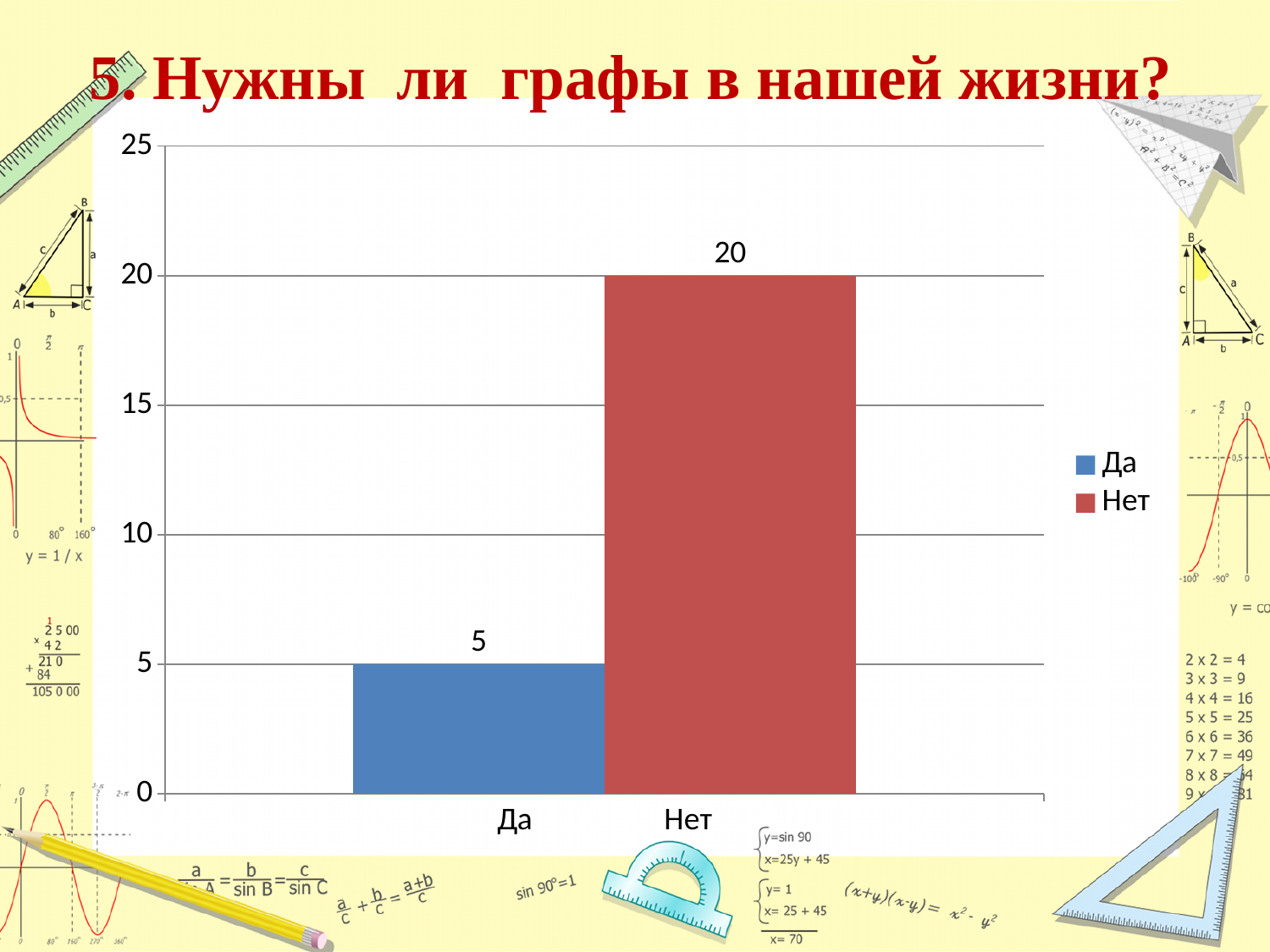
Which is larger, the value for "Да" or the value for "Нет"? Нет What kind of chart is shown on the slide? bar chart Is the value for "Нет" greater or less than 15? greater How many categories are shown on the x axis? 2 What is the value for "Да"? 5 How many entries does the legend list? 2 Which category has the highest value? Нет What is the value for "Нет"? 20 What colour is the bar for "Нет"? red What is the difference between the values for "Нет" and "Да"? 15 Which category has the lowest value? Да Is the value for "Да" greater or less than 10? less